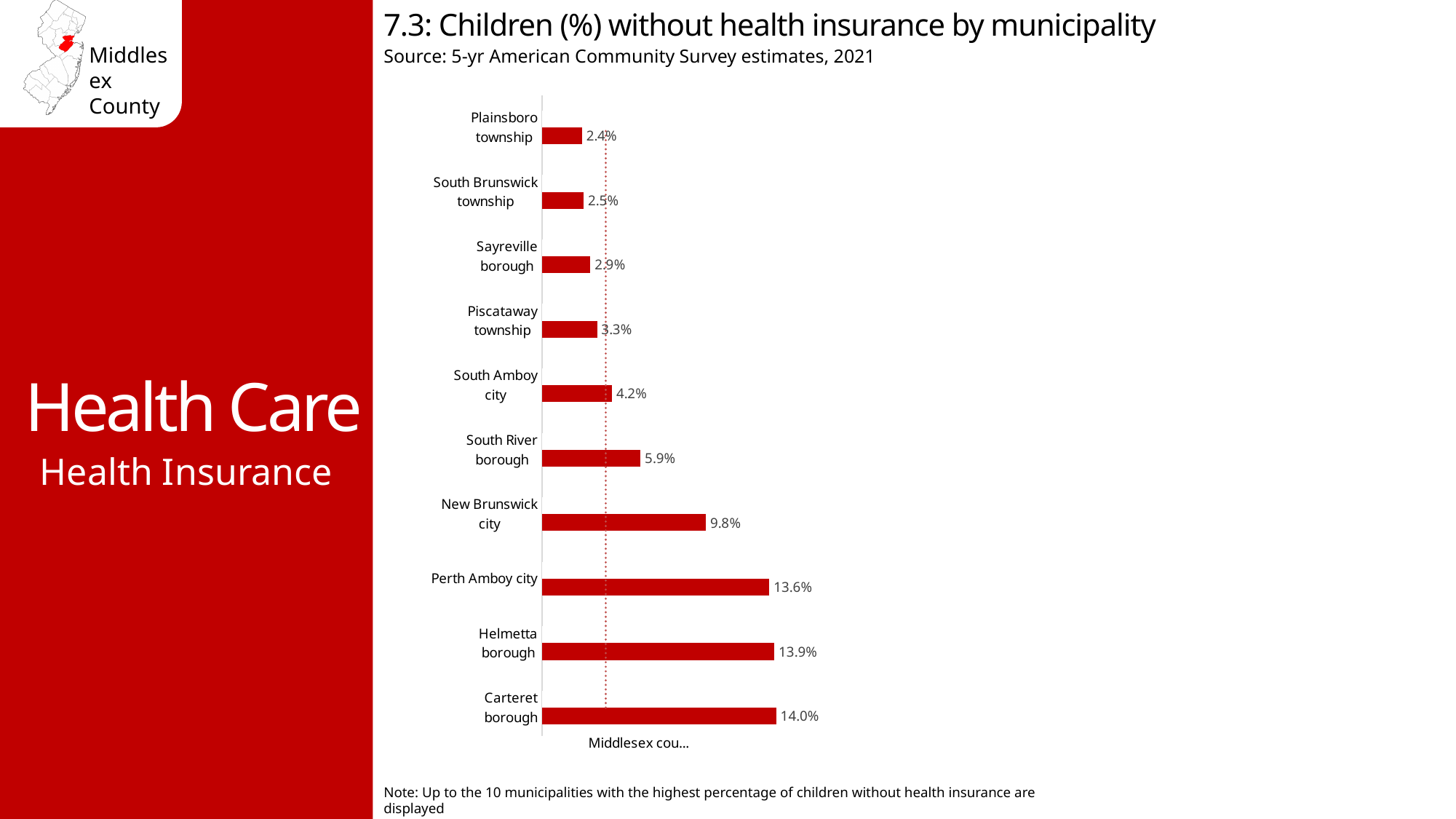
Which has a higher value, South Amboy city or Sayreville borough? South Amboy city What percentage of children are without health insurance in Carteret borough? 14.0% Which municipality has the lowest percentage of children without health insurance? Plainsboro township What is the source of the data shown in the chart? 5-yr American Community Survey estimates, 2021 Which has a higher value, New Brunswick city or Perth Amboy city? Perth Amboy city What is the value shown for New Brunswick city? 9.8% What is the difference between the values for Perth Amboy city and South River borough? 7.7% What is the difference between the values for Helmetta borough and Carteret borough? 0.1% How many municipalities are shown in the chart? 10 What kind of chart is shown on the slide? Bar chart What is the value shown for Piscataway township? 3.3% Which municipality has the highest percentage of children without health insurance? Carteret borough